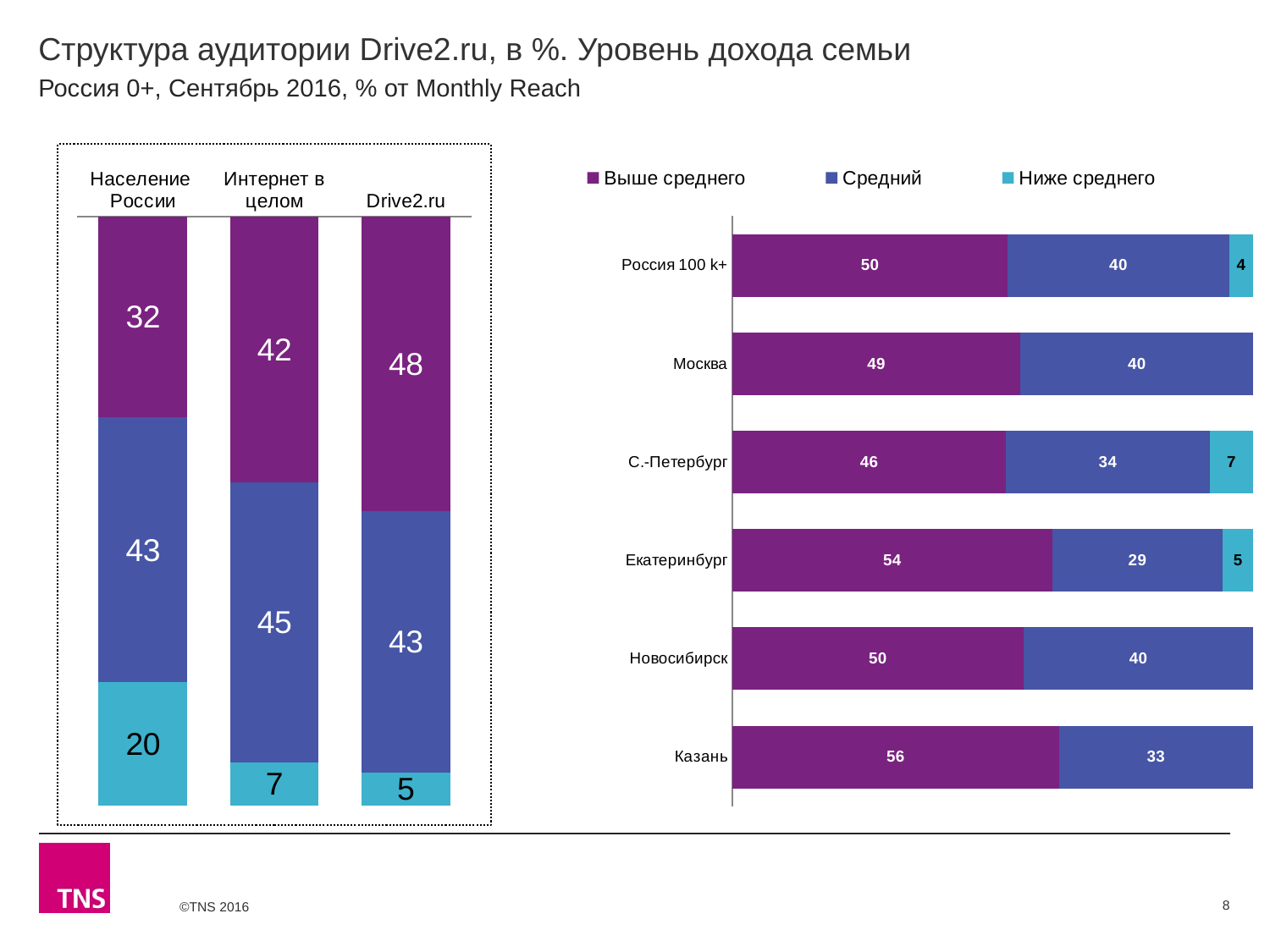
In the left chart, what is the value of the bottom (light blue) segment for Население России? 20 In the left chart, what is the difference between the top segment values for Drive2.ru and Население России? 16 In the left chart, how many categories are shown on the x axis? 3 In the right chart, what is the Выше среднего value for Казань? 56 How many series does the legend of the right chart list? 3 In the right chart, which category has the lowest Средний value? Екатеринбург In the right chart, what is the Средний value for Екатеринбург? 29 In the right chart, what is the total of the stacked bar for С.-Петербург? 87 In the left chart, what is the total of the stacked bar for Drive2.ru? 96 In the right chart, which category has the highest Выше среднего value? Казань In the left chart, what is the value of the middle (blue) segment for Интернет в целом? 45 In the left chart, what is the value of the top (purple) segment for Drive2.ru? 48